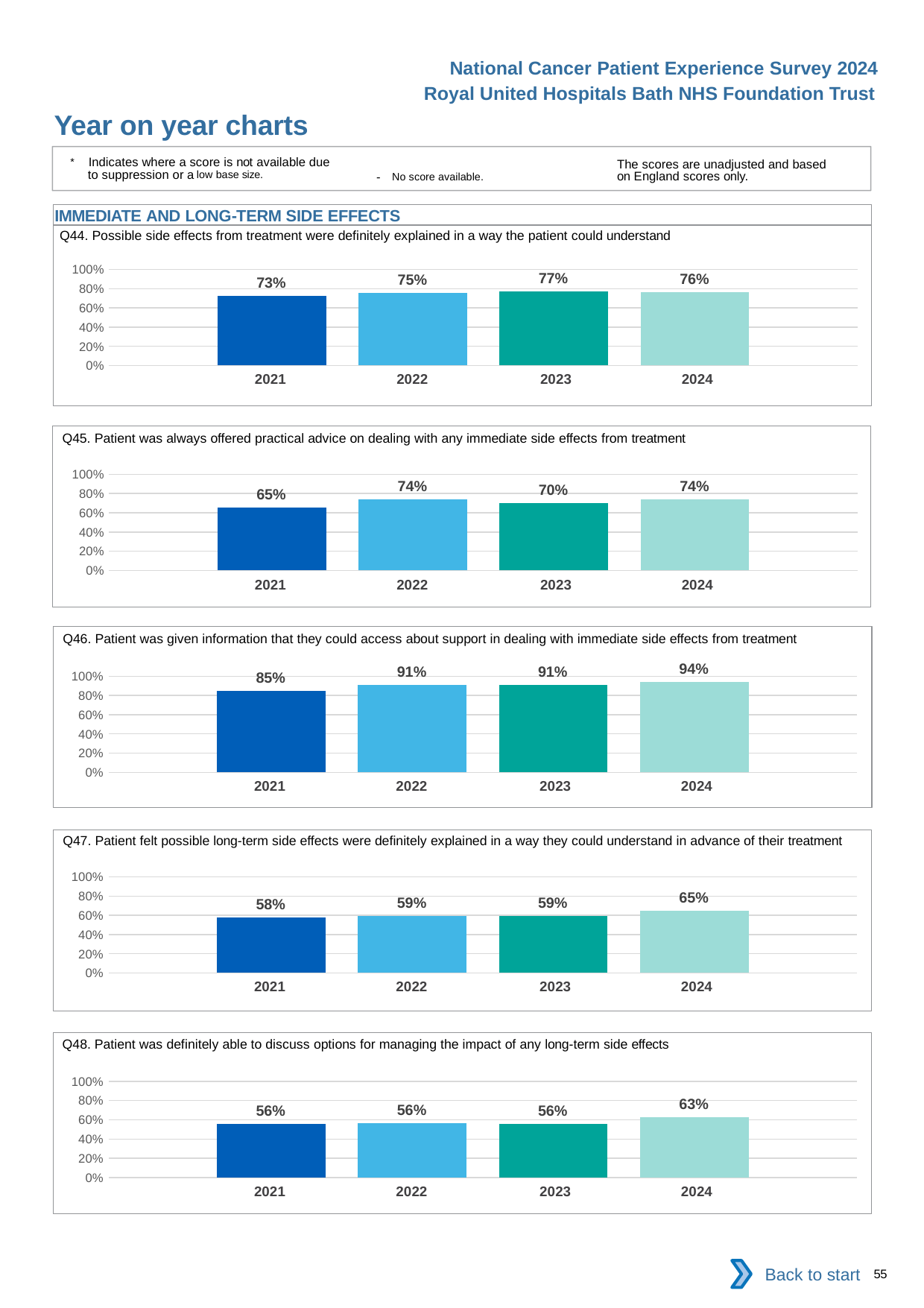
In the Q45 chart, what is the difference between the 2022 and 2021 values? 9% How many years are shown in the Q44 chart? 4 In the Q48 chart, is the value for 2024 larger than the value for 2023? Yes In the Q46 chart, do the values generally rise or fall from 2021 to 2024? Rise In the Q45 chart, which year has the lowest value? 2021 In the Q48 chart, what is the value for 2024? 63% In the Q46 chart, what is the value for 2024? 94% In the Q46 chart, what is the difference between the 2024 and 2021 values? 9% What is the section heading above the Q44 chart? IMMEDIATE AND LONG-TERM SIDE EFFECTS What type of chart is the Q47 chart? Bar chart In the Q44 chart, what is the value for 2023? 77% In the Q47 chart, which year has the highest value? 2024